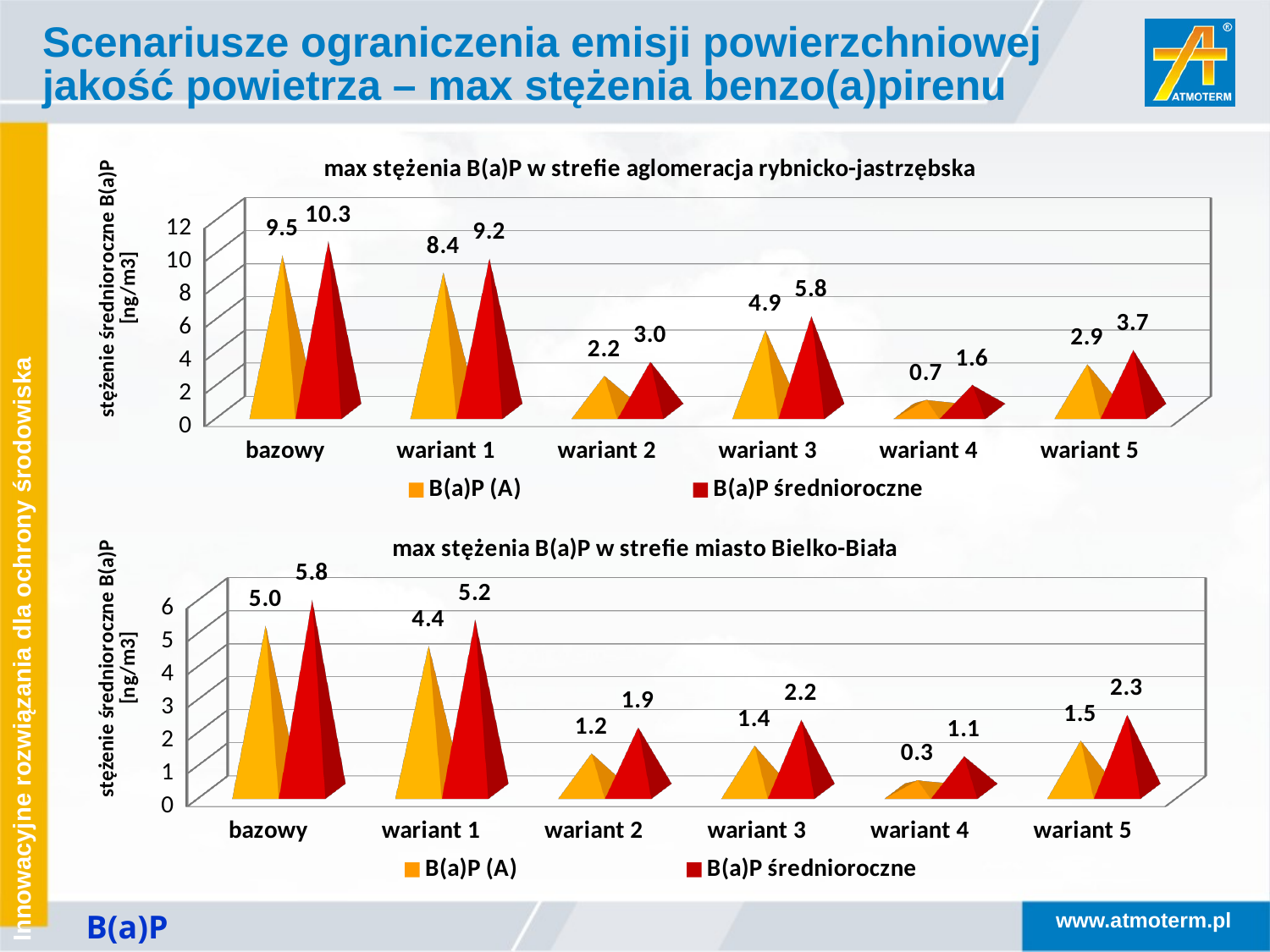
In the top chart (aglomeracja rybnicko-jastrzębska), what is the difference between the B(a)P średnioroczne and B(a)P (A) values for wariant 1? 0.8 In the bottom chart (miasto Bielsko-Biała), what is the B(a)P średnioroczne value for wariant 5? 2.3 In the bottom chart (miasto Bielsko-Biała), which category has the highest B(a)P średnioroczne value? bazowy In the top chart (aglomeracja rybnicko-jastrzębska), what is the B(a)P (A) value for wariant 3? 4.9 In the bottom chart (miasto Bielsko-Biała), what is the B(a)P (A) value for wariant 2? 1.2 In the top chart (aglomeracja rybnicko-jastrzębska), which category has the lowest B(a)P (A) value? wariant 4 How many series does the legend of the bottom chart (miasto Bielsko-Biała) list? 2 In the top chart (aglomeracja rybnicko-jastrzębska), how many categories are shown on the x axis? 6 In the bottom chart (miasto Bielsko-Biała), which is larger: the B(a)P (A) value for wariant 3 or for wariant 5? wariant 5 In the bottom chart (miasto Bielsko-Biała), what is the difference between the B(a)P średnioroczne values for bazowy and wariant 1? 0.6 What type of chart is the top chart (aglomeracja rybnicko-jastrzębska)? bar chart In the top chart (aglomeracja rybnicko-jastrzębska), what is the B(a)P średnioroczne value for bazowy? 10.3